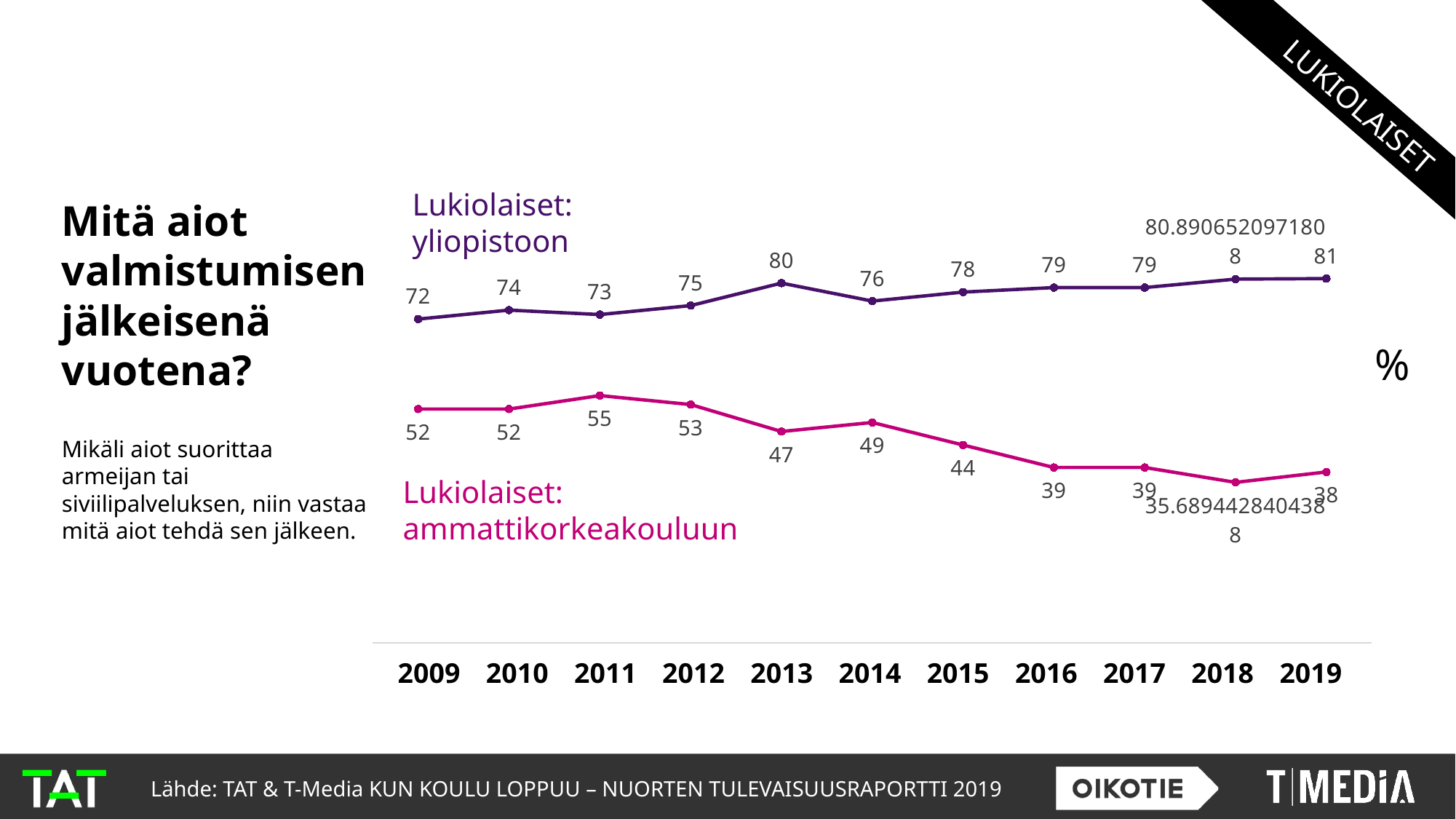
What is the value for Lukiolaiset: ammattikorkeakouluun in 2016? 39 How many series does the chart show? 2 What is the value for Lukiolaiset: yliopistoon in 2009? 72 What is the value for Lukiolaiset: yliopistoon in 2013? 80 How many years are shown on the x axis? 11 What colour is the line for Lukiolaiset: ammattikorkeakouluun? pink In which year is the Lukiolaiset: ammattikorkeakouluun series highest? 2011 Does the Lukiolaiset: ammattikorkeakouluun series generally rise or fall from 2009 to 2019? fall Which series has the larger value in 2015, Lukiolaiset: yliopistoon or Lukiolaiset: ammattikorkeakouluun? Lukiolaiset: yliopistoon What kind of chart is shown on the slide? line chart What is the difference between the Lukiolaiset: yliopistoon and Lukiolaiset: ammattikorkeakouluun values in 2019? 43 In which year is the Lukiolaiset: yliopistoon series lowest? 2009